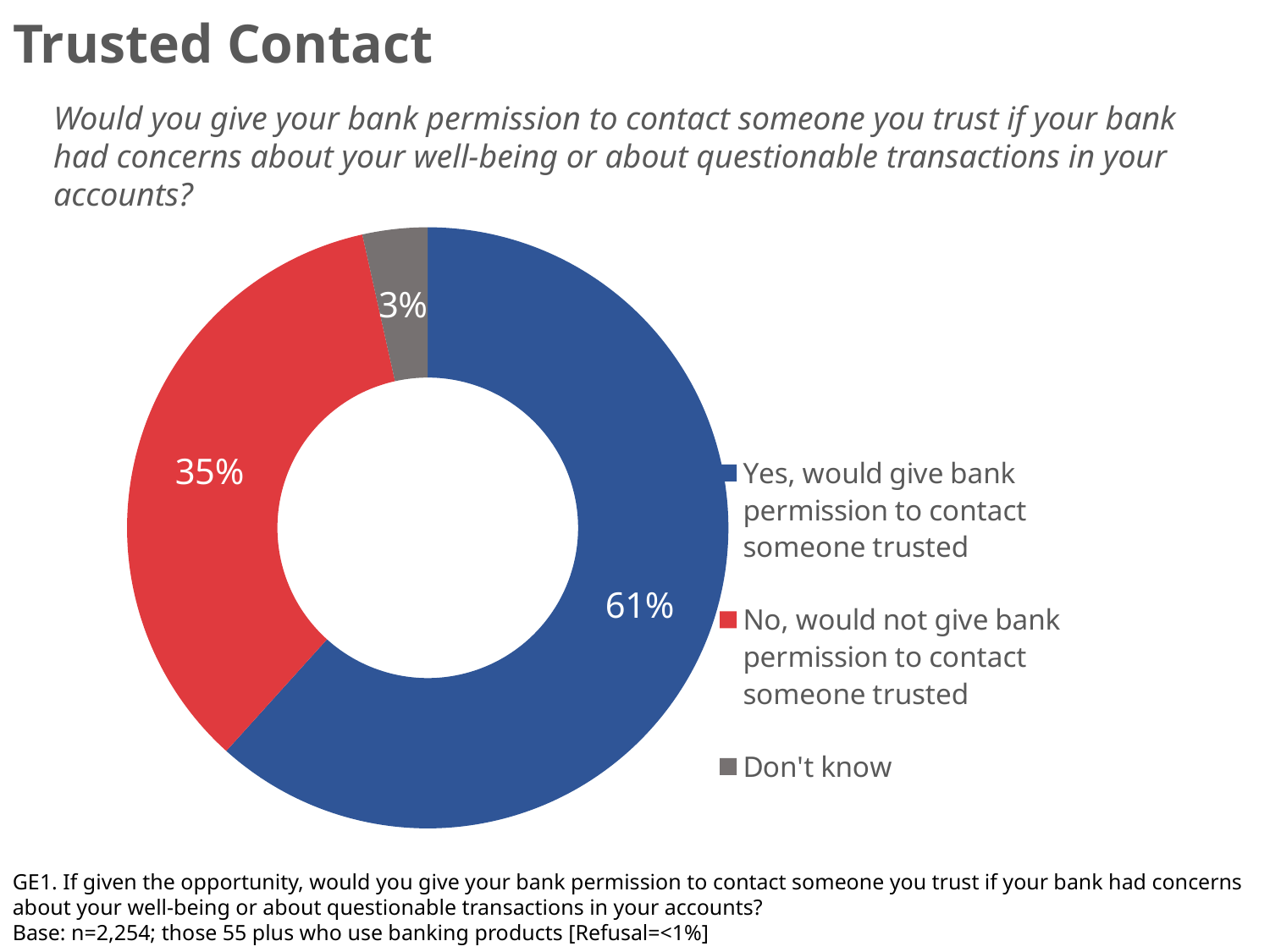
Which response has the largest share of the chart? Yes, would give bank permission to contact someone trusted What percentage of respondents said yes, they would give the bank permission to contact someone trusted? 61% What percentage of respondents said no, they would not give the bank permission to contact someone trusted? 35% How many response categories are shown in the chart? 3 What colour represents the 'Don't know' response? Grey How many entries does the legend list? 3 What is the sample size (n) stated in the base note below the chart? 2,254 Which response has the smallest share of the chart? Don't know Which is larger: the share who would give permission or the share who would not? Yes, would give bank permission to contact someone trusted What is the difference in percentage points between the 'Yes' and 'No' responses? 26 What kind of chart is shown on the slide? Pie chart (doughnut) What percentage of respondents answered 'Don't know'? 3%